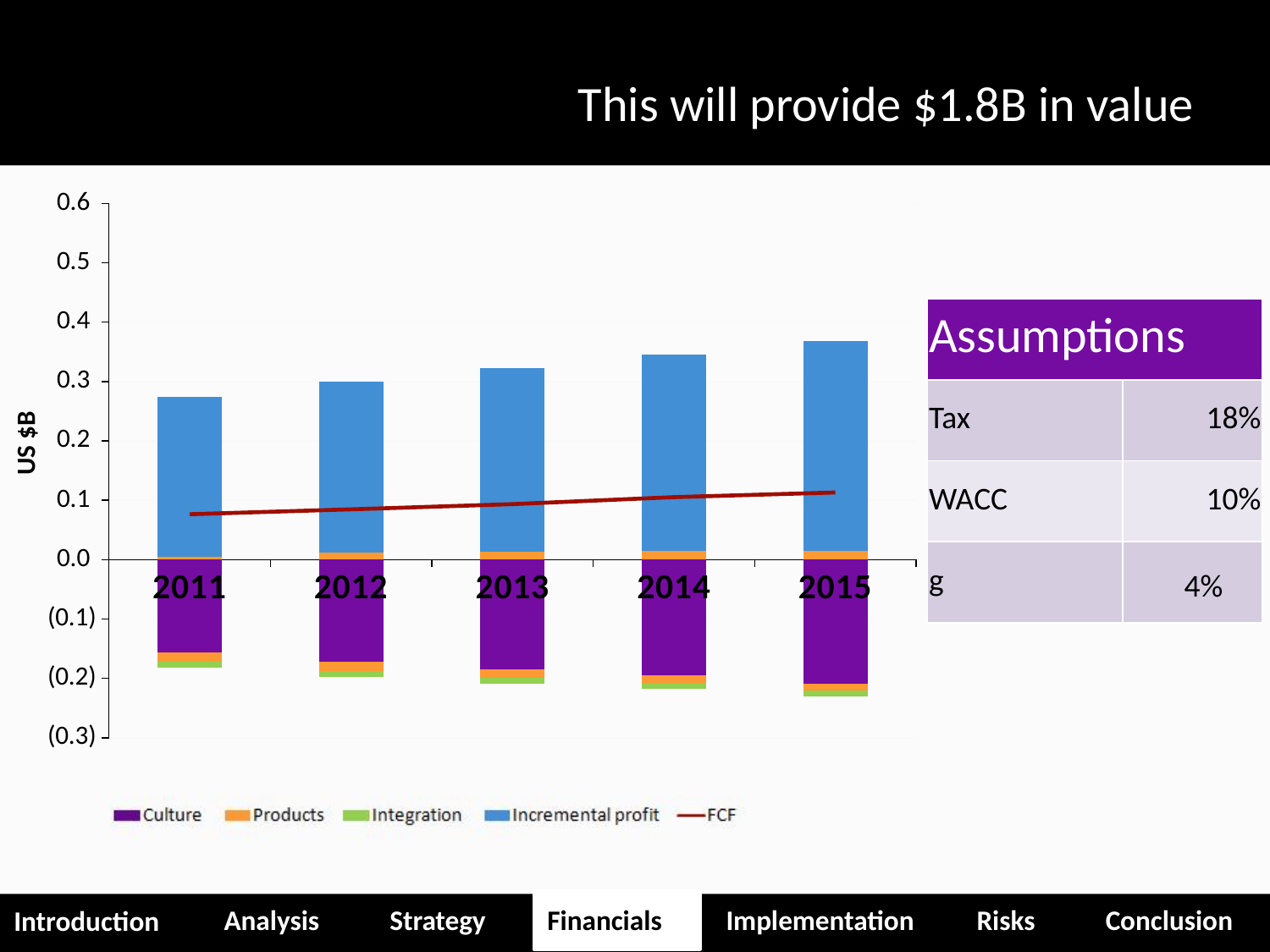
What is the label on the y axis of the chart? US $B What type of chart is shown on the slide? Stacked bar chart with a line Is the FCF value for 2011 greater or less than 0.1? less Is the Incremental profit value for 2015 greater or less than 0.3? greater Does the Incremental profit series rise or fall from 2011 to 2015? Rise Which year has the lowest Incremental profit bar? 2011 Does the FCF line rise or fall from 2011 to 2015? Rise Which is larger, the Incremental profit bar for 2015 or for 2011? 2015 How many years are shown on the x axis of the chart? 5 Is the Incremental profit value for 2011 greater or less than 0.3? less Which year has the highest Incremental profit bar? 2015 How many series does the chart legend list? 5